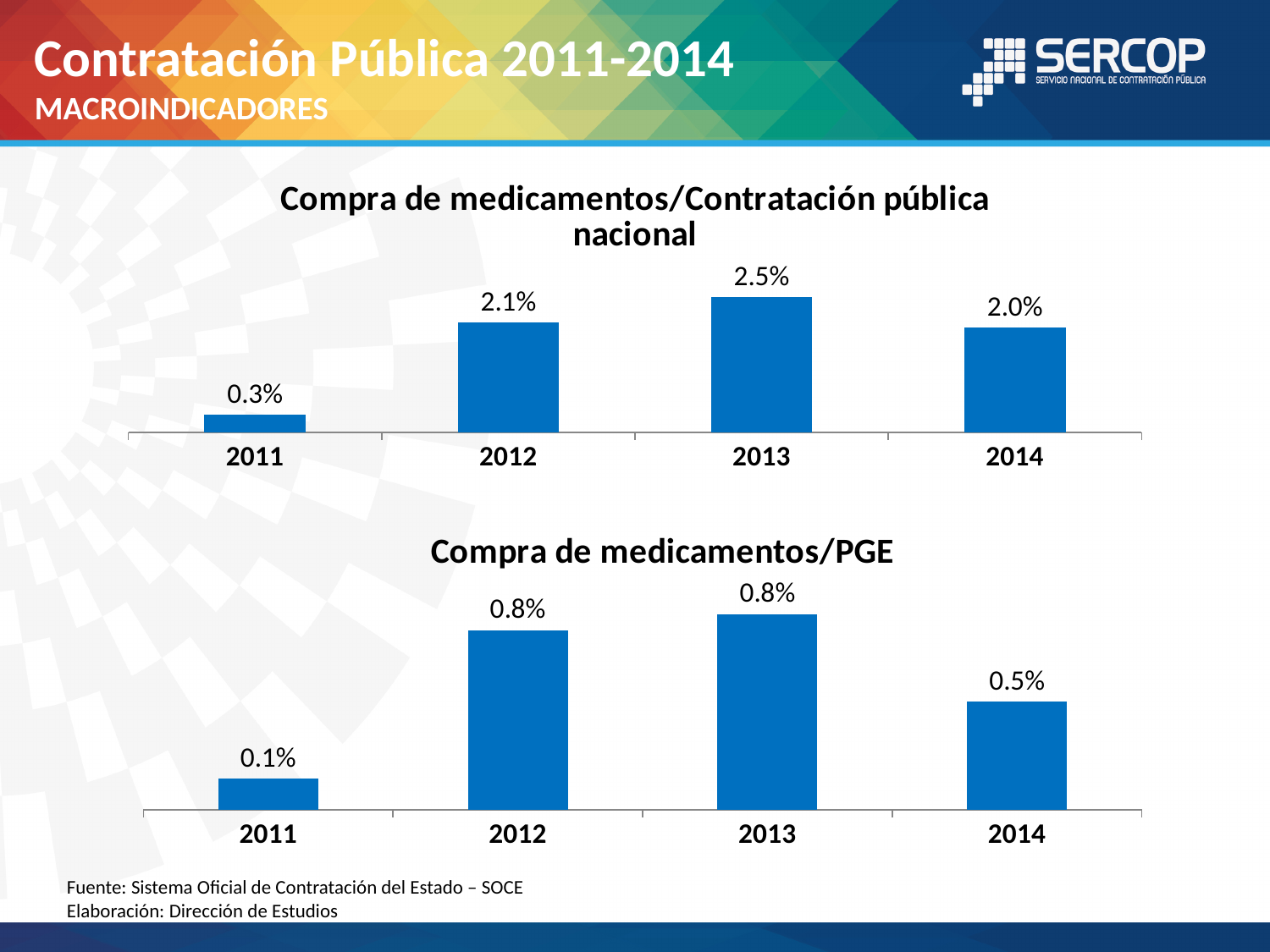
In the chart titled 'Compra de medicamentos/Contratación pública nacional', which year has the highest value? 2013 In the chart titled 'Compra de medicamentos/PGE', is the value for 2012 larger or smaller than the value for 2014? larger In the chart titled 'Compra de medicamentos/Contratación pública nacional', which year has the lowest value? 2011 In the chart titled 'Compra de medicamentos/Contratación pública nacional', what is the difference between the values for 2013 and 2014? 0.5% In the chart titled 'Compra de medicamentos/Contratación pública nacional', what is the value for 2011? 0.3% In the chart titled 'Compra de medicamentos/PGE', what is the value for 2011? 0.1% In the chart titled 'Compra de medicamentos/PGE', what is the value for 2014? 0.5% In the chart titled 'Compra de medicamentos/Contratación pública nacional', how many years are shown on the x axis? 4 In the chart titled 'Compra de medicamentos/PGE', what is the difference between the values for 2012 and 2011? 0.7% In the chart titled 'Compra de medicamentos/Contratación pública nacional', what is the value for 2013? 2.5% In the chart titled 'Compra de medicamentos/PGE', which year has the lowest value? 2011 What kind of chart is the chart titled 'Compra de medicamentos/PGE'? bar chart